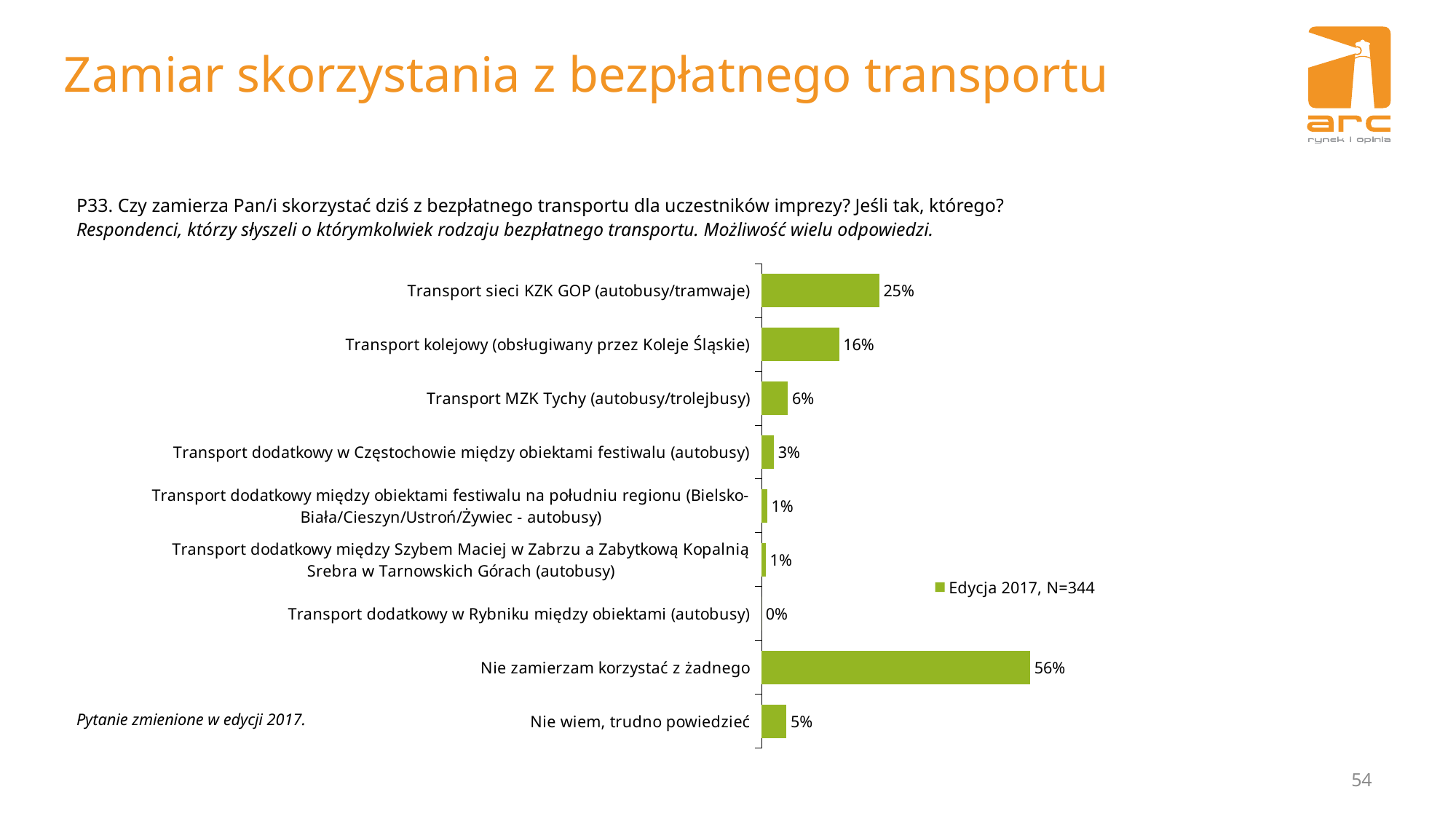
What is the difference between "Nie zamierzam korzystać z żadnego" and "Transport sieci KZK GOP (autobusy/tramwaje)"? 31 percentage points Which category has the highest value? Nie zamierzam korzystać z żadnego What is the value for "Transport sieci KZK GOP (autobusy/tramwaje)"? 25% What is the value for "Nie wiem, trudno powiedzieć"? 5% How many categories are shown in the chart? 9 What is the legend entry of the chart? Edycja 2017, N=344 Which category has the lowest value? Transport dodatkowy w Rybniku między obiektami (autobusy) What kind of chart is shown on the slide? Bar chart What is the value for "Transport MZK Tychy (autobusy/trolejbusy)"? 6% How many series does the legend list? 1 Which is larger: "Transport kolejowy (obsługiwany przez Koleje Śląskie)" or "Transport MZK Tychy (autobusy/trolejbusy)"? Transport kolejowy (obsługiwany przez Koleje Śląskie) What is the value for "Transport kolejowy (obsługiwany przez Koleje Śląskie)"? 16%